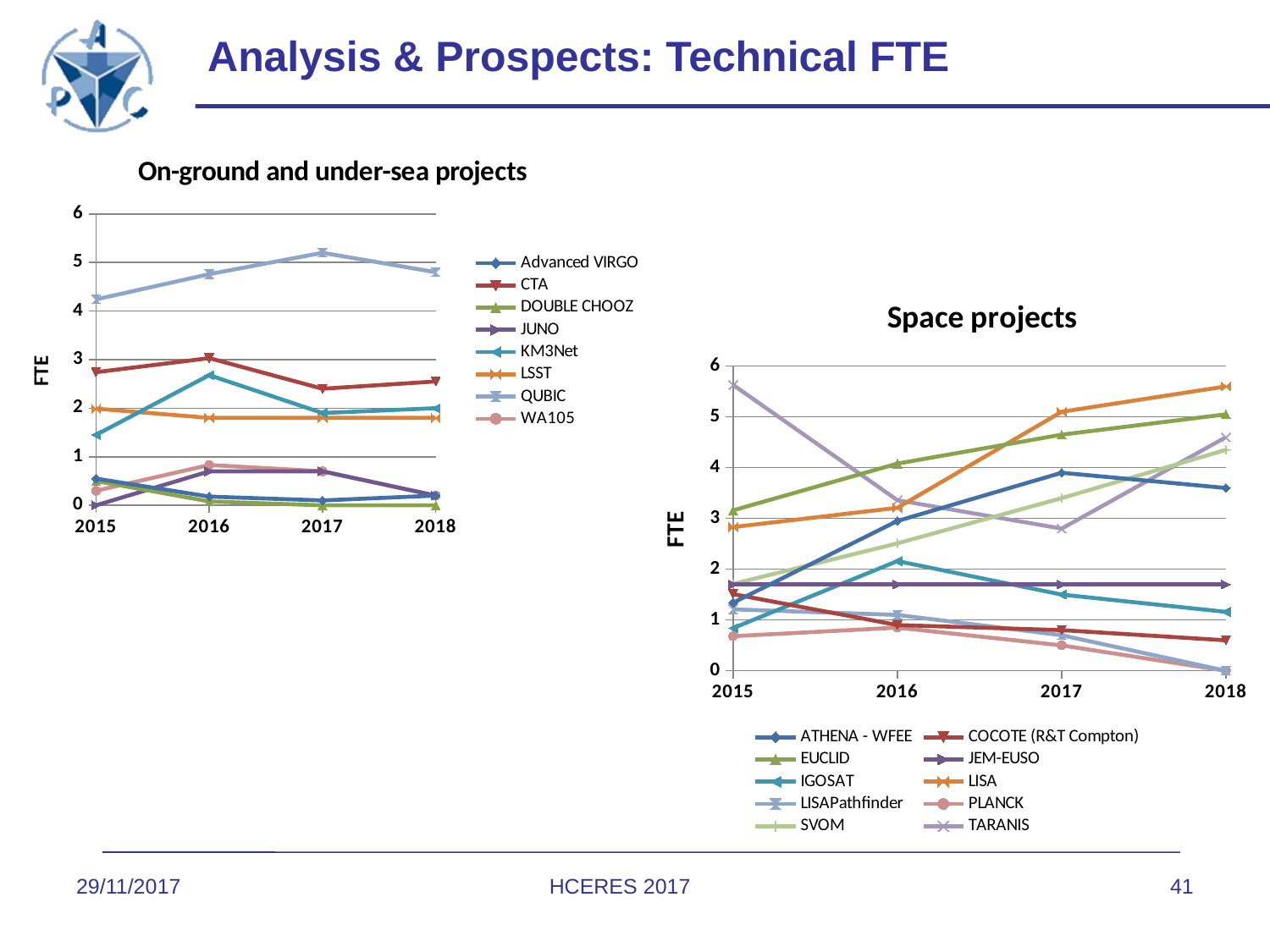
In the 'Space projects' chart, which is larger in 2018, the FTE for LISA or for EUCLID? LISA What is the label on the y axis of the 'Space projects' chart? FTE In the 'On-ground and under-sea projects' chart, is the FTE for QUBIC in 2017 greater or less than 5? greater How many series does the legend of the 'On-ground and under-sea projects' chart list? 8 What kind of chart is the 'On-ground and under-sea projects' chart? line chart How many years are shown on the x axis of the 'Space projects' chart? 4 In the 'Space projects' chart, which project has the highest FTE in 2015? TARANIS In the 'Space projects' chart, which project has the highest FTE in 2018? LISA In the 'On-ground and under-sea projects' chart, which project has the highest FTE in 2017? QUBIC In the 'Space projects' chart, does the FTE for LISA rise or fall from 2015 to 2018? rise How many series does the legend of the 'Space projects' chart list? 10 In the 'On-ground and under-sea projects' chart, is the FTE for KM3Net in 2016 greater or less than 2? greater